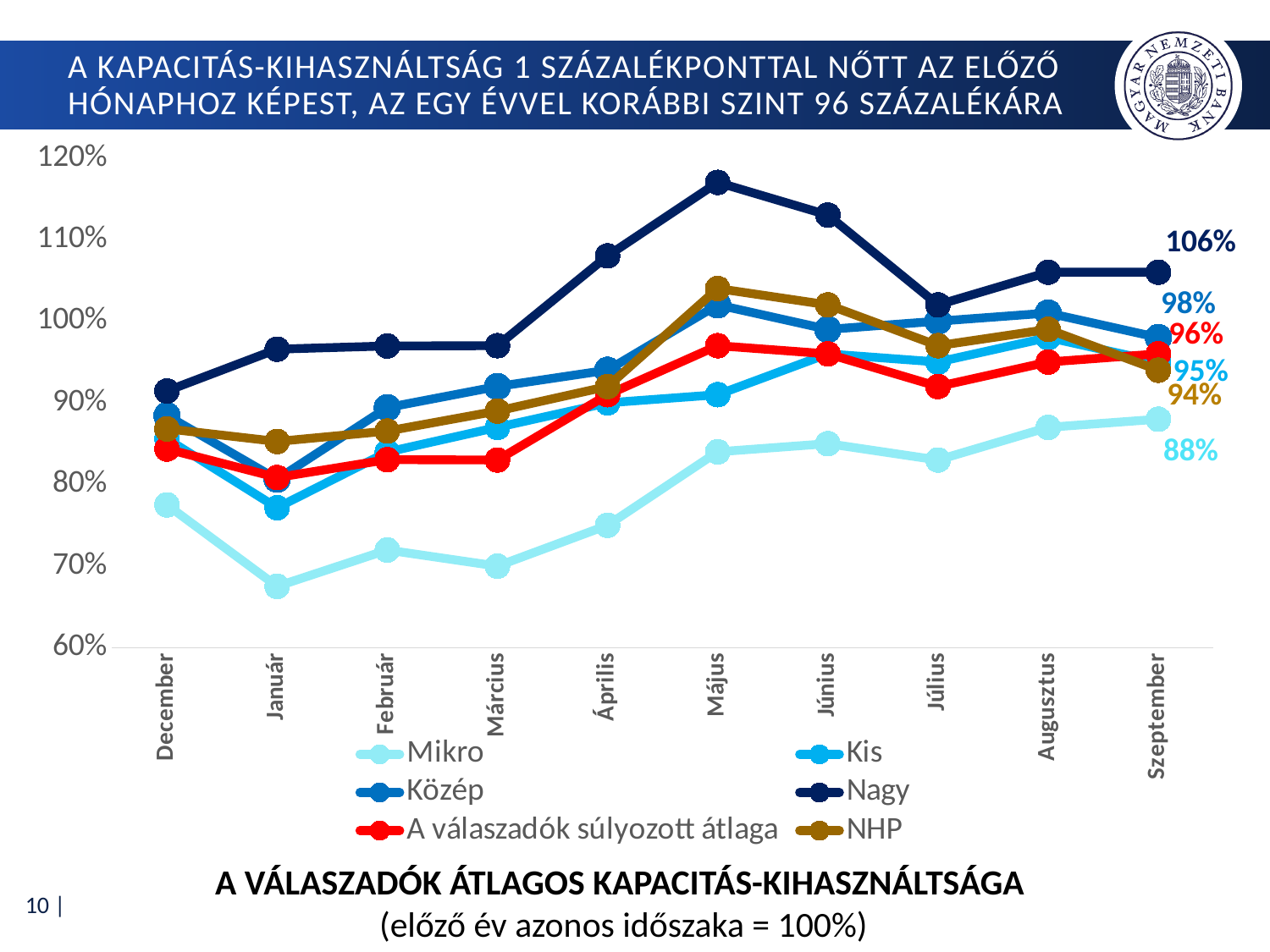
What is the value for A válaszadók súlyozott átlaga in Szeptember? 96% What is the value for Mikro in Szeptember? 88% How many series does the legend list? 6 Which series has the lowest value in Szeptember? Mikro How many months are shown on the x axis? 10 What is the value for Közép in Szeptember? 98% Is the value for Nagy in Május greater or less than 110%? greater What is the value for Nagy in Szeptember? 106% What type of chart is shown on the slide? line chart Is the value for Mikro in Január greater or less than 70%? less Which series has the highest value in Szeptember? Nagy What is the difference between the Nagy and Mikro values in Szeptember? 18 percentage points